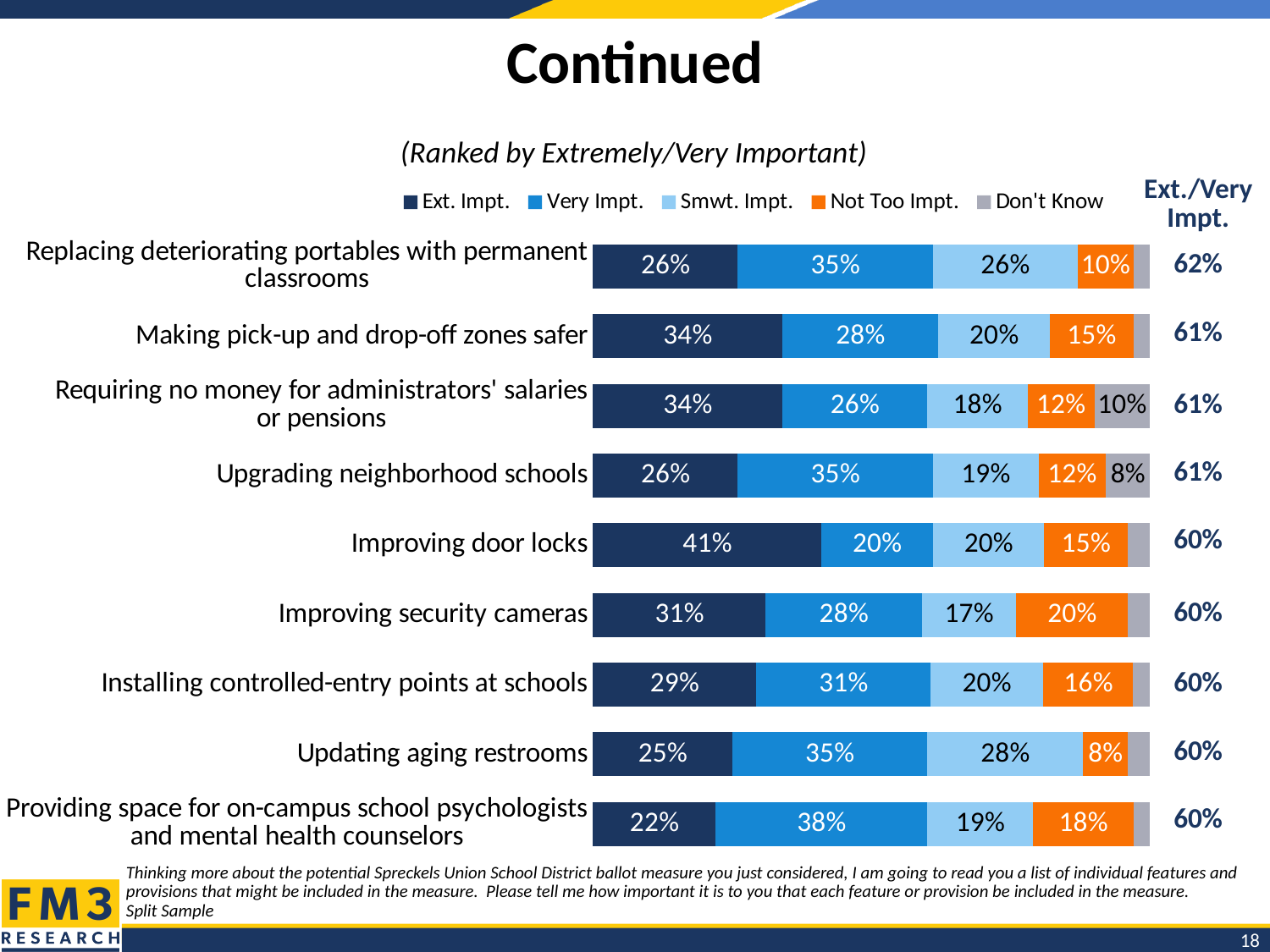
Which category has the lowest Ext. Impt. value? Providing space for on-campus school psychologists and mental health counselors Which category has the highest Ext. Impt. value? Improving door locks What is the Not Too Impt. value for "Improving security cameras"? 20% How many series does the legend list? 5 How many categories (features) are plotted in the chart? 9 What is the Ext./Very Impt. total shown for "Replacing deteriorating portables with permanent classrooms"? 62% Which is larger: the Smwt. Impt. value for "Updating aging restrooms" or the Smwt. Impt. value for "Improving security cameras"? Updating aging restrooms What is the Ext. Impt. value for "Improving door locks"? 41% What is the Don't Know value for "Requiring no money for administrators' salaries or pensions"? 10% What kind of chart is shown on the slide? Stacked bar chart What is the difference between the Ext. Impt. value for "Making pick-up and drop-off zones safer" and the Ext. Impt. value for "Updating aging restrooms"? 9% What is the Very Impt. value for "Providing space for on-campus school psychologists and mental health counselors"? 38%